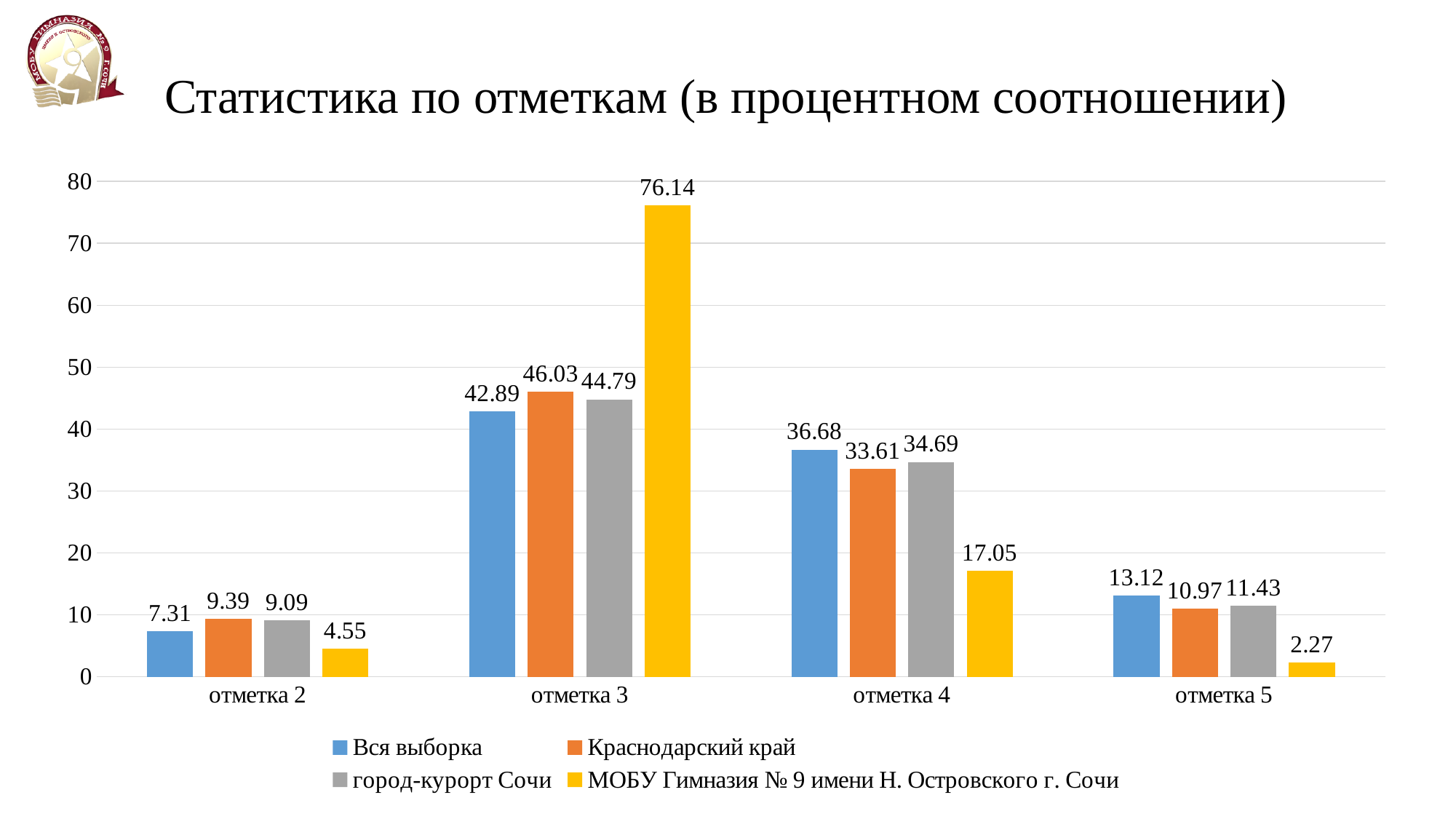
How many series does the legend list? 4 Which category has the lowest value for the Вся выборка series? отметка 2 What is the title of the chart? Статистика по отметкам (в процентном соотношении) What is the value for город-курорт Сочи at отметка 5? 11.43 Which is larger at отметка 4: Вся выборка or Краснодарский край? Вся выборка Which category has the highest value for the МОБУ Гимназия № 9 series? отметка 3 What is the value for Краснодарский край at отметка 2? 9.39 What is the value for МОБУ Гимназия № 9 имени Н. Островского г. Сочи at отметка 3? 76.14 What is the difference between the МОБУ Гимназия № 9 value and the Вся выборка value at отметка 3? 33.25 What is the value for Вся выборка at отметка 4? 36.68 How many categories are shown on the x axis? 4 What kind of chart is shown on the slide? bar chart